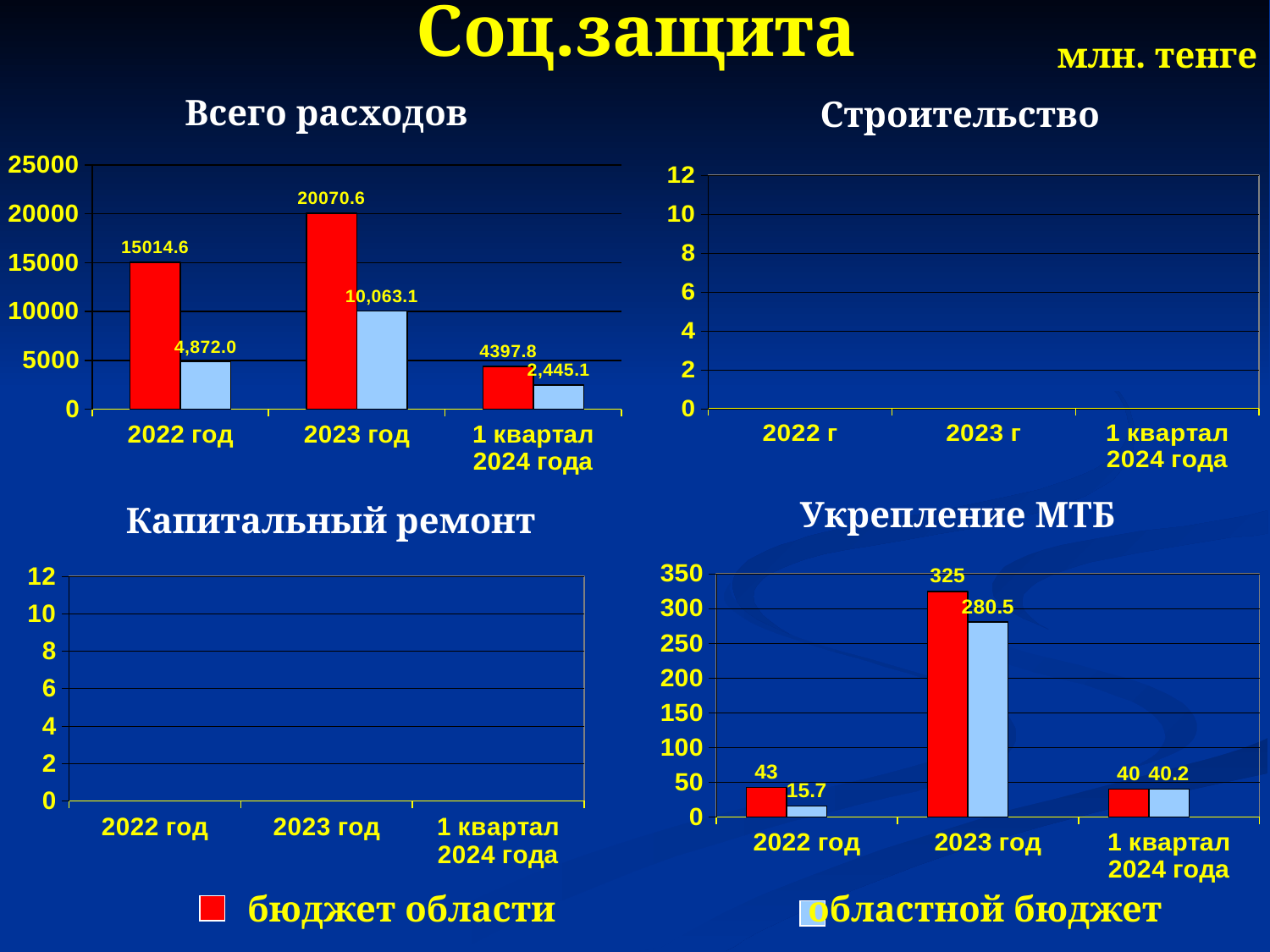
In the 'Всего расходов' chart, is the red bar for 2022 год greater or less than 10000? greater In the 'Укрепление МТБ' chart, which category has the lowest red bar? 1 квартал 2024 года In the 'Всего расходов' chart, how many categories are shown on the x axis? 3 In the 'Всего расходов' chart, which category has the highest red bar? 2023 год In the 'Всего расходов' chart, what is the value of the red bar for 2023 год? 20070.6 According to the legend at the bottom of the slide, what does the red colour represent? бюджет области In the 'Укрепление МТБ' chart, for 2022 год, which is larger: the red bar or the light blue bar? the red bar In the 'Укрепление МТБ' chart, what is the difference between the red and light blue bars for 2023 год? 44.5 In the 'Укрепление МТБ' chart, what is the value of the light blue bar for 1 квартал 2024 года? 40.2 In the 'Всего расходов' chart, what is the value of the light blue bar for 2022 год? 4,872.0 In the 'Укрепление МТБ' chart, what is the value of the red bar for 2022 год? 43 What kind of chart is 'Укрепление МТБ'? bar chart